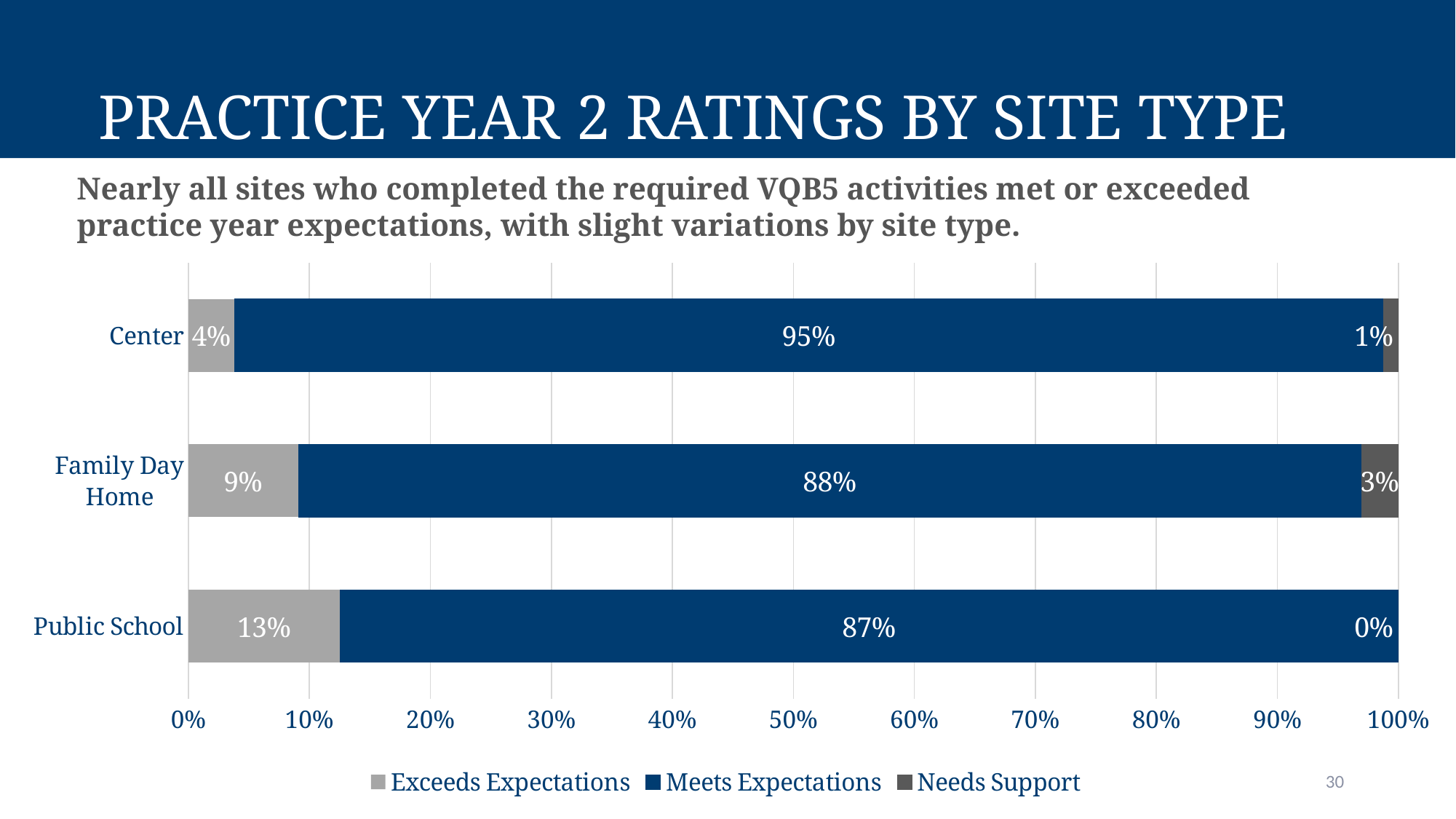
How many site types are shown in the chart? 3 What is the difference between the Exceeds Expectations percentages for Public School and Center sites? 9% Which is larger: the Meets Expectations percentage for Center or for Family Day Home? Center What is the Needs Support percentage for Public School sites? 0% What percentage of Family Day Home sites received a Needs Support rating? 3% How many series does the legend list? 3 What kind of chart is shown on the slide? Stacked bar chart Which site type has the highest Exceeds Expectations percentage? Public School What percentage of Center sites received a Meets Expectations rating? 95% Which legend entry is shown in dark blue? Meets Expectations Which site type has the lowest Meets Expectations percentage? Public School What percentage of Public School sites received an Exceeds Expectations rating? 13%